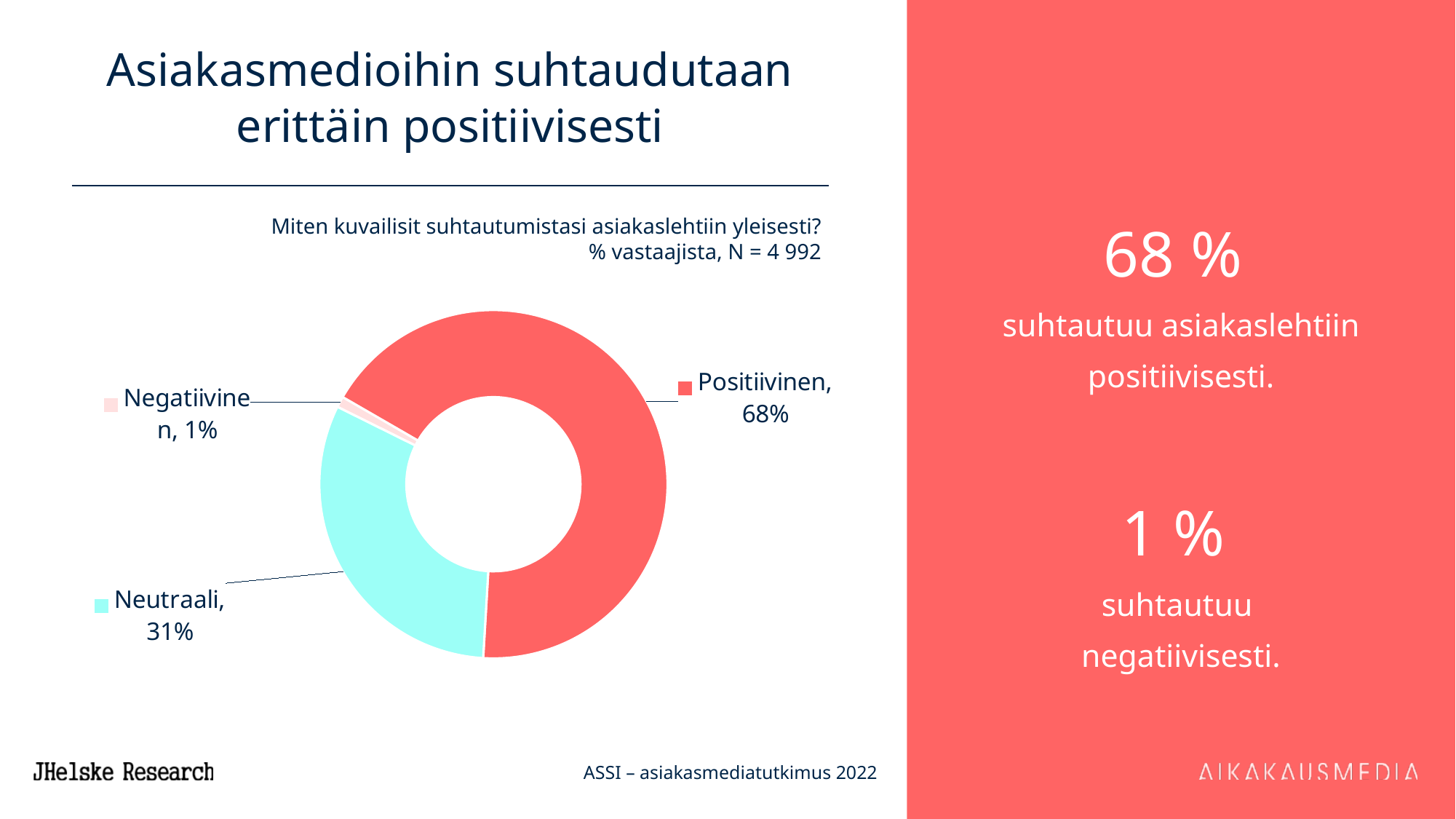
What is the difference in percentage points between Neutraali and Negatiivinen? 30 What is the sample size (N) stated above the chart? 4 992 What colour is the Neutraali slice of the chart? Light blue (cyan) Which is larger, the share for Neutraali or the share for Negatiivinen? Neutraali What percentage of respondents are Neutraali? 31% Which category has the largest share of the chart? Positiivinen What percentage of respondents are Negatiivinen? 1% How many categories does the chart show? 3 What percentage of respondents are Positiivinen? 68% What kind of chart is shown on the slide? Pie chart (doughnut) Which category has the smallest share of the chart? Negatiivinen What is the difference in percentage points between Positiivinen and Neutraali? 37